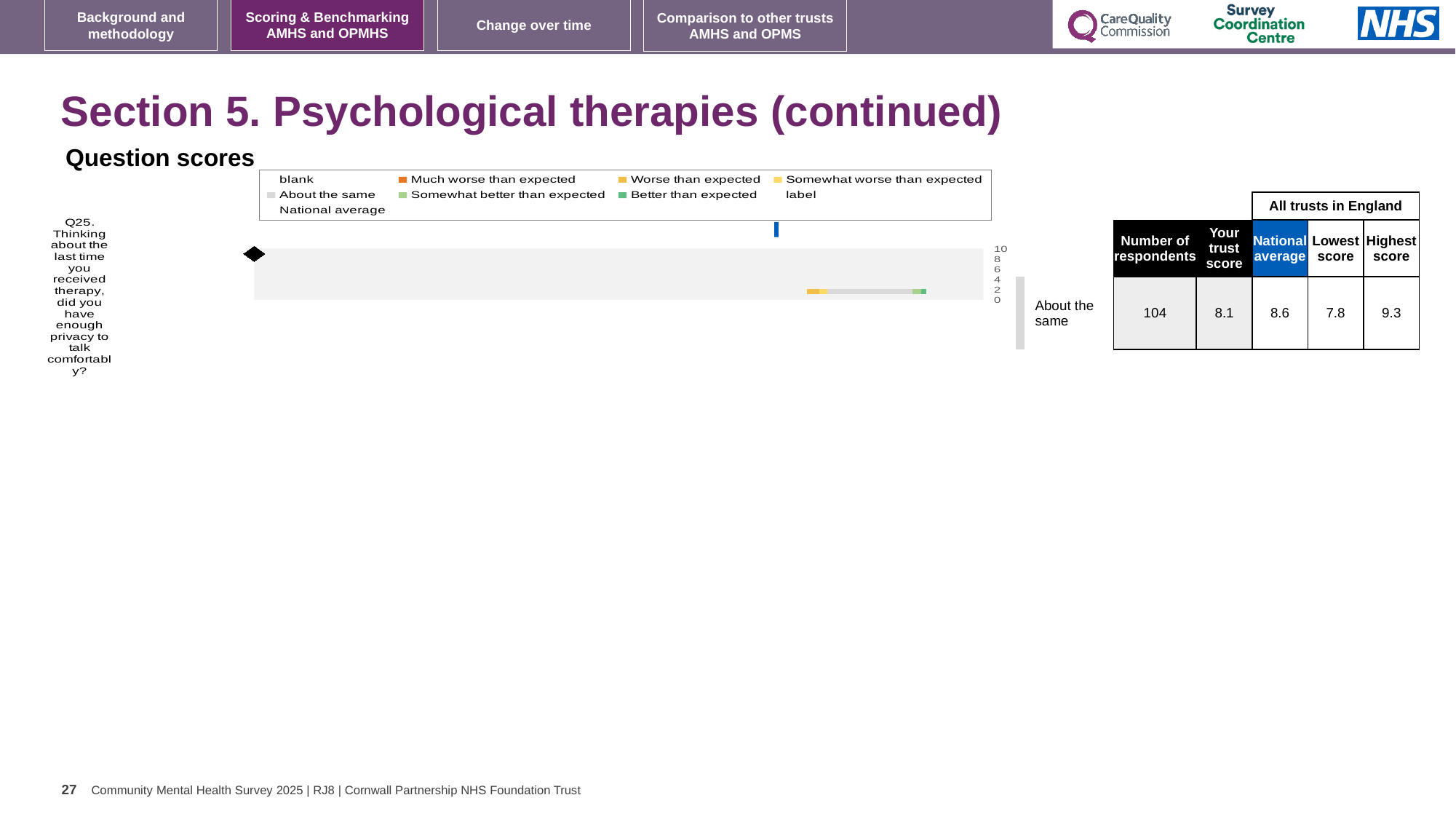
What colour does the legend use for 'Much worse than expected'? orange In the table beside the chart, what is the highest score among all trusts in England for Q25? 9.3 In the table beside the chart, how many respondents answered Q25? 104 For Q25, what is the difference between the highest score and the lowest score among all trusts in England? 1.5 In the table beside the chart, what is the trust score for Q25? 8.1 In the table beside the chart, what is the national average for Q25? 8.6 What kind of chart is shown under 'Question scores'? bar chart In the table beside the chart, what is the lowest score among all trusts in England for Q25? 7.8 How many survey questions are plotted in the chart? 1 For Q25, which is larger: the trust score or the national average? national average Which benchmark category is shown for Q25 next to the chart? About the same How many entries does the chart's legend list? 9